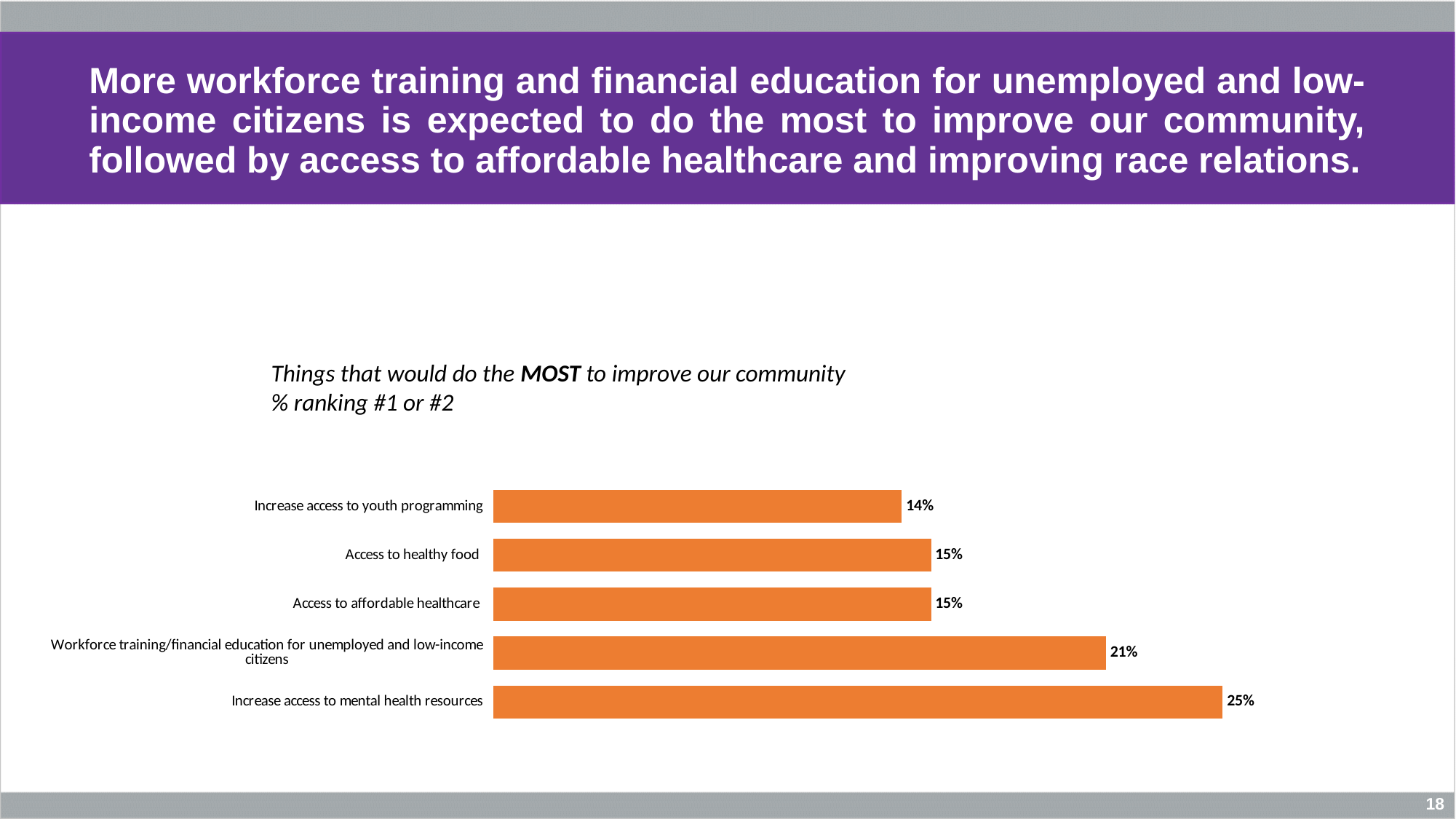
What kind of chart is shown on the slide? Bar chart What is the difference between 'Increase access to mental health resources' and 'Workforce training/financial education for unemployed and low-income citizens'? 4 percentage points Which category has the lowest value? Increase access to youth programming What percentage ranked 'Increase access to mental health resources' as #1 or #2? 25% What is the value for 'Workforce training/financial education for unemployed and low-income citizens'? 21% What is the value for 'Increase access to youth programming'? 14% What is the title of the chart? Things that would do the MOST to improve our community % ranking #1 or #2 Which is larger: the value for 'Workforce training/financial education for unemployed and low-income citizens' or 'Access to affordable healthcare'? Workforce training/financial education for unemployed and low-income citizens What is the value for 'Access to healthy food'? 15% Which category has the highest value? Increase access to mental health resources How many categories are shown in the chart? 5 What is the difference between 'Access to affordable healthcare' and 'Increase access to youth programming'? 1 percentage point